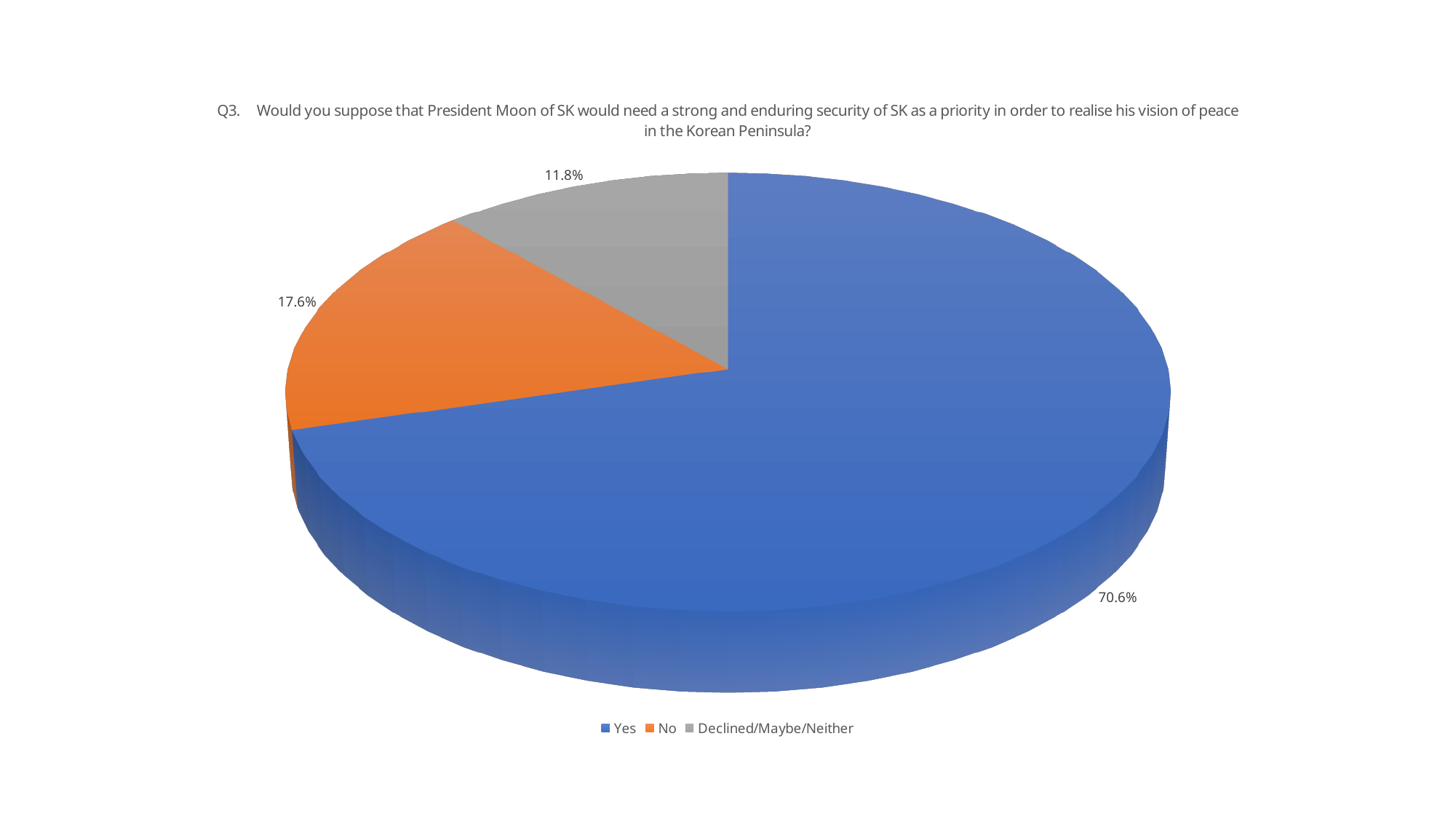
Which is larger, the share for "No" or the share for "Declined/Maybe/Neither"? No What is the difference in percentage points between the "Yes" and "No" shares? 53.0 percentage points Which response category has the largest share? Yes What is the difference in percentage points between the "No" and "Declined/Maybe/Neither" shares? 5.8 percentage points What share of responses is "Declined/Maybe/Neither"? 11.8% What colour is the "Declined/Maybe/Neither" slice? Grey What colour is the "Yes" slice? Blue What share of responses is "Yes"? 70.6% What share of responses is "No"? 17.6% Which response category has the smallest share? Declined/Maybe/Neither What kind of chart is shown on the slide? Pie chart How many categories does the legend list? 3